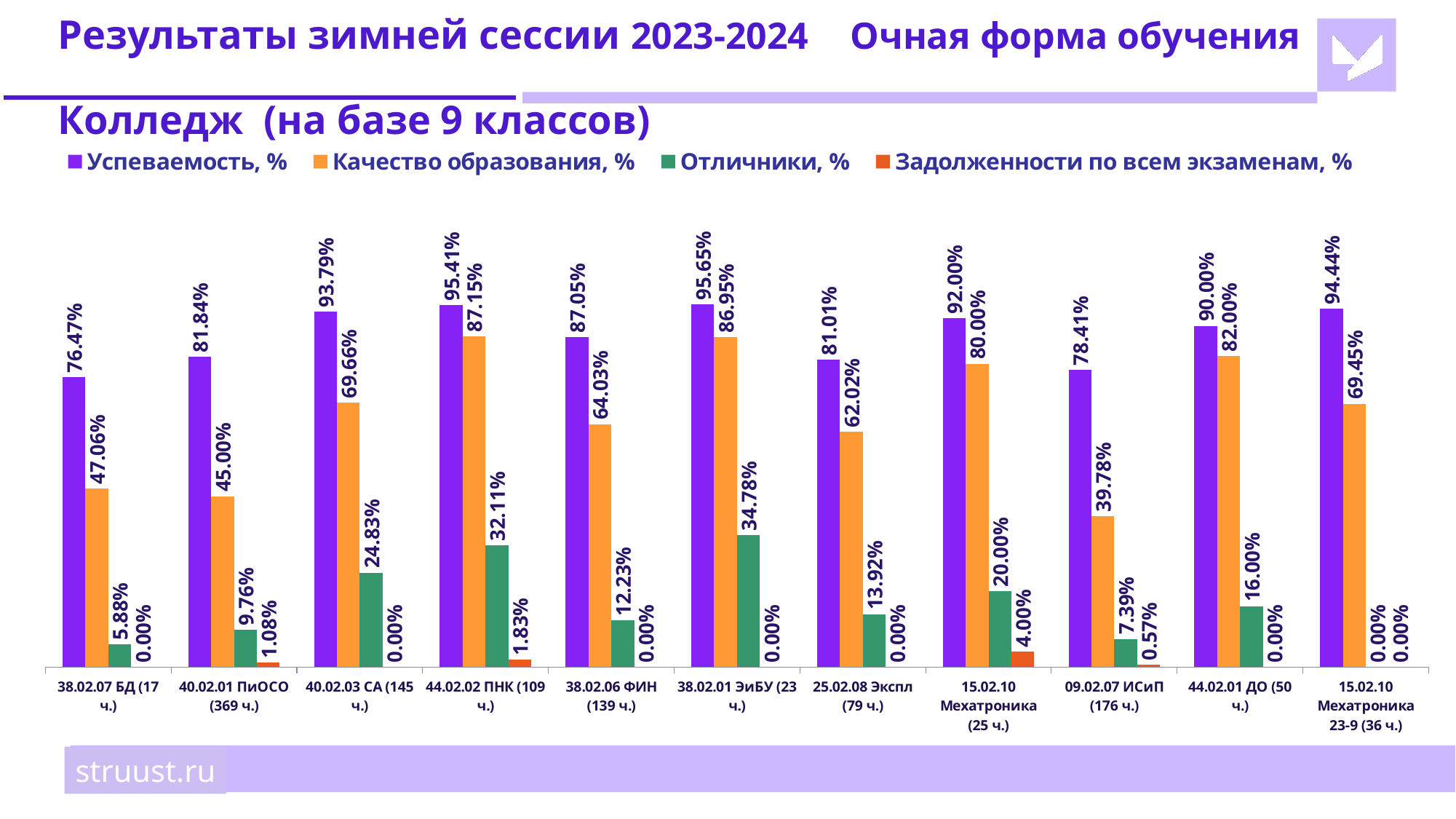
What is the Успеваемость, % value for 38.02.07 БД (17 ч.)? 76.47% What is the Задолженности по всем экзаменам, % value for 09.02.07 ИСиП (176 ч.)? 0.57% How many series does the legend list? 4 Which category has the highest Задолженности по всем экзаменам, % value? 15.02.10 Мехатроника (25 ч.) What kind of chart is shown on the slide? Bar chart Which category has the lowest Успеваемость, % value? 38.02.07 БД (17 ч.) Which is larger: the Отличники, % value for 38.02.01 ЭиБУ (23 ч.) or for 44.02.02 ПНК (109 ч.)? 38.02.01 ЭиБУ (23 ч.) Which category has the highest Успеваемость, % value? 38.02.01 ЭиБУ (23 ч.) How many categories are shown on the x axis? 11 What is the difference between Успеваемость, % and Качество образования, % for 44.02.02 ПНК (109 ч.)? 8.26% What is the Качество образования, % value for 15.02.10 Мехатроника (25 ч.)? 80.00% What is the Отличники, % value for 40.02.03 СА (145 ч.)? 24.83%